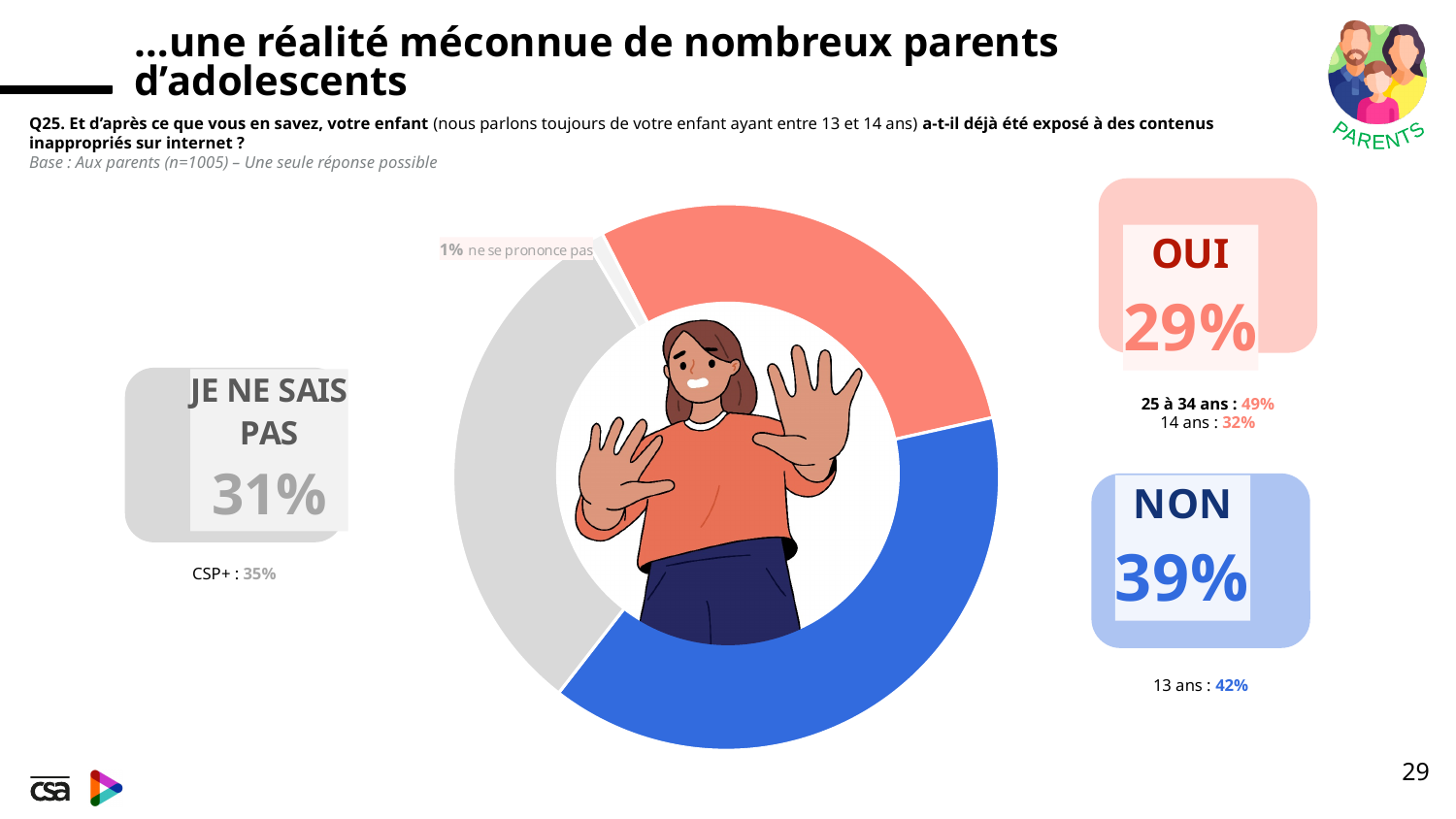
What percentage of parents answered "NON"? 39% What percentage of parents answered "OUI"? 29% What colour is the "NON" segment of the donut chart? Blue What is the combined share of "OUI" and "NON"? 68% Which is larger, the share for "JE NE SAIS PAS" or the share for "OUI"? JE NE SAIS PAS Which answer has the smallest share of the donut chart? ne se prononce pas How many answer categories are shown in the donut chart? 4 What percentage of parents answered "JE NE SAIS PAS"? 31% Which answer has the largest share of the donut chart? NON What percentage of parents "ne se prononce pas"? 1% What is the difference in percentage points between "NON" and "OUI"? 10 points What kind of chart is shown on the slide? Donut (pie) chart